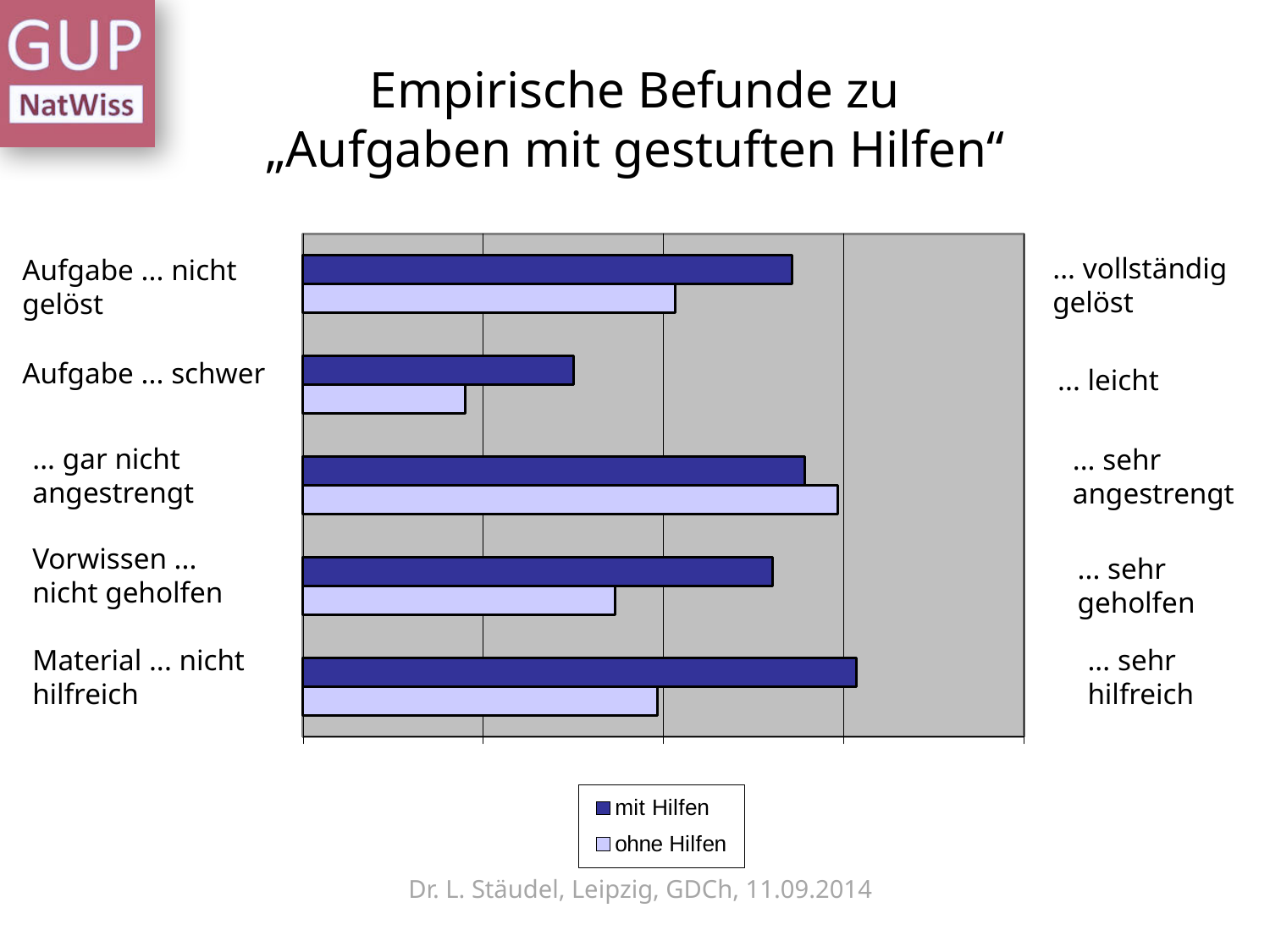
How many series does the legend list? 2 How many categories (pairs of bars) are plotted in the chart? 5 In which category is the ohne Hilfen bar the longest? ... gar nicht angestrengt / ... sehr angestrengt For the category "Aufgabe ... nicht gelöst / ... vollständig gelöst", which series has the longer bar, mit Hilfen or ohne Hilfen? mit Hilfen For the category "Aufgabe ... schwer / ... leicht", which series has the longer bar, mit Hilfen or ohne Hilfen? mit Hilfen For the category "Material ... nicht hilfreich / ... sehr hilfreich", which series has the longer bar, mit Hilfen or ohne Hilfen? mit Hilfen In which category is the mit Hilfen bar the shortest? Aufgabe ... schwer / ... leicht Which series is drawn in dark blue? mit Hilfen What kind of chart is shown on the slide? bar chart What are the two series named in the legend? mit Hilfen, ohne Hilfen In which category is the mit Hilfen bar the longest? Material ... nicht hilfreich / ... sehr hilfreich